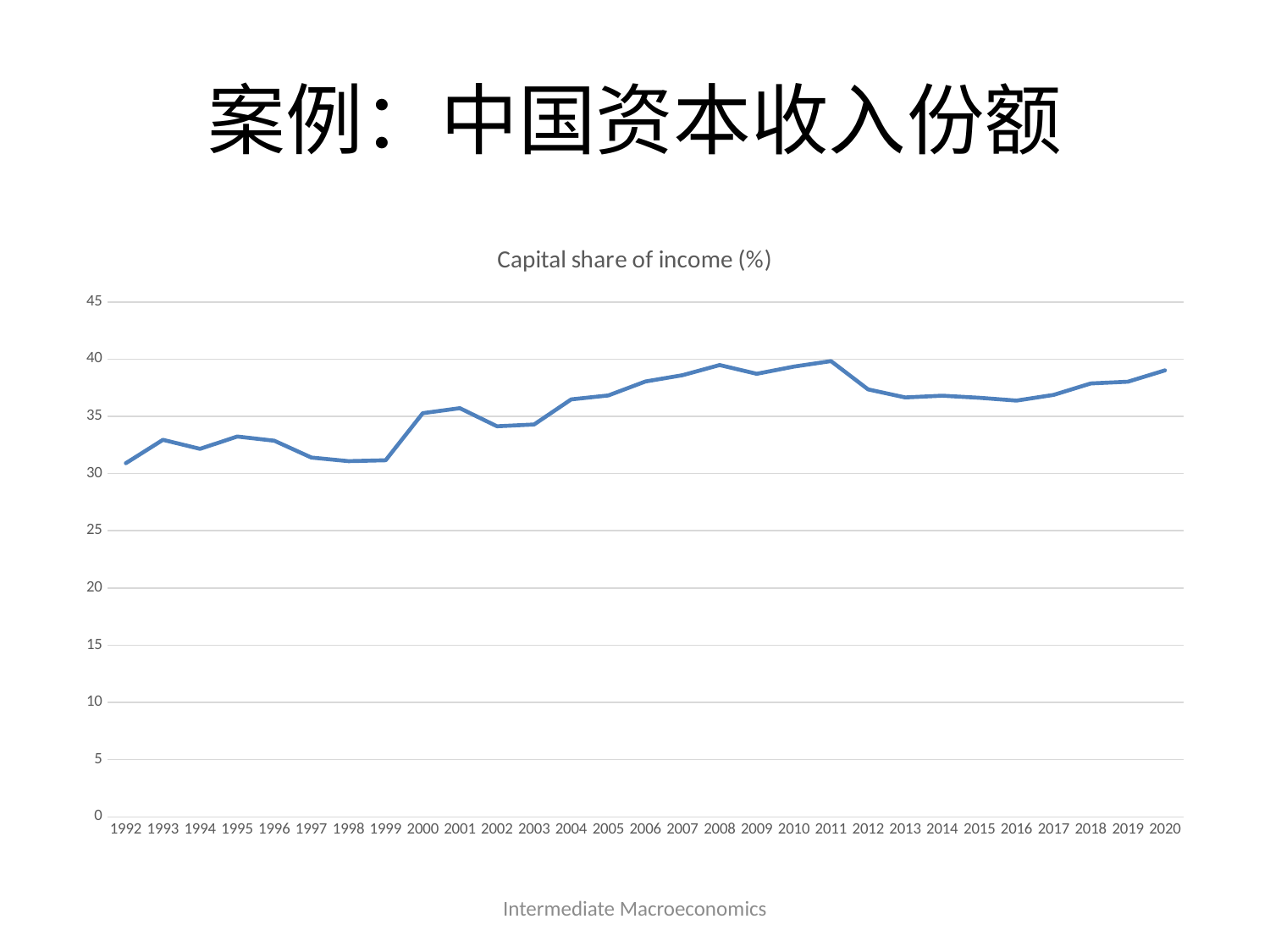
Which year has the larger value, 1992 or 2020? 2020 Which year has the larger value, 1999 or 2000? 2000 Which year has the larger value, 2011 or 2016? 2011 Is the value for 1992 greater or less than 35? less How many years are plotted along the x axis of the chart? 29 Is the value for 2016 greater or less than 35? greater Is the value for 1998 greater or less than 30? greater What is the title of the chart? Capital share of income (%) What type of chart is shown on the slide? line chart Overall, does the capital share of income rise or fall from 1992 to 2020? rise